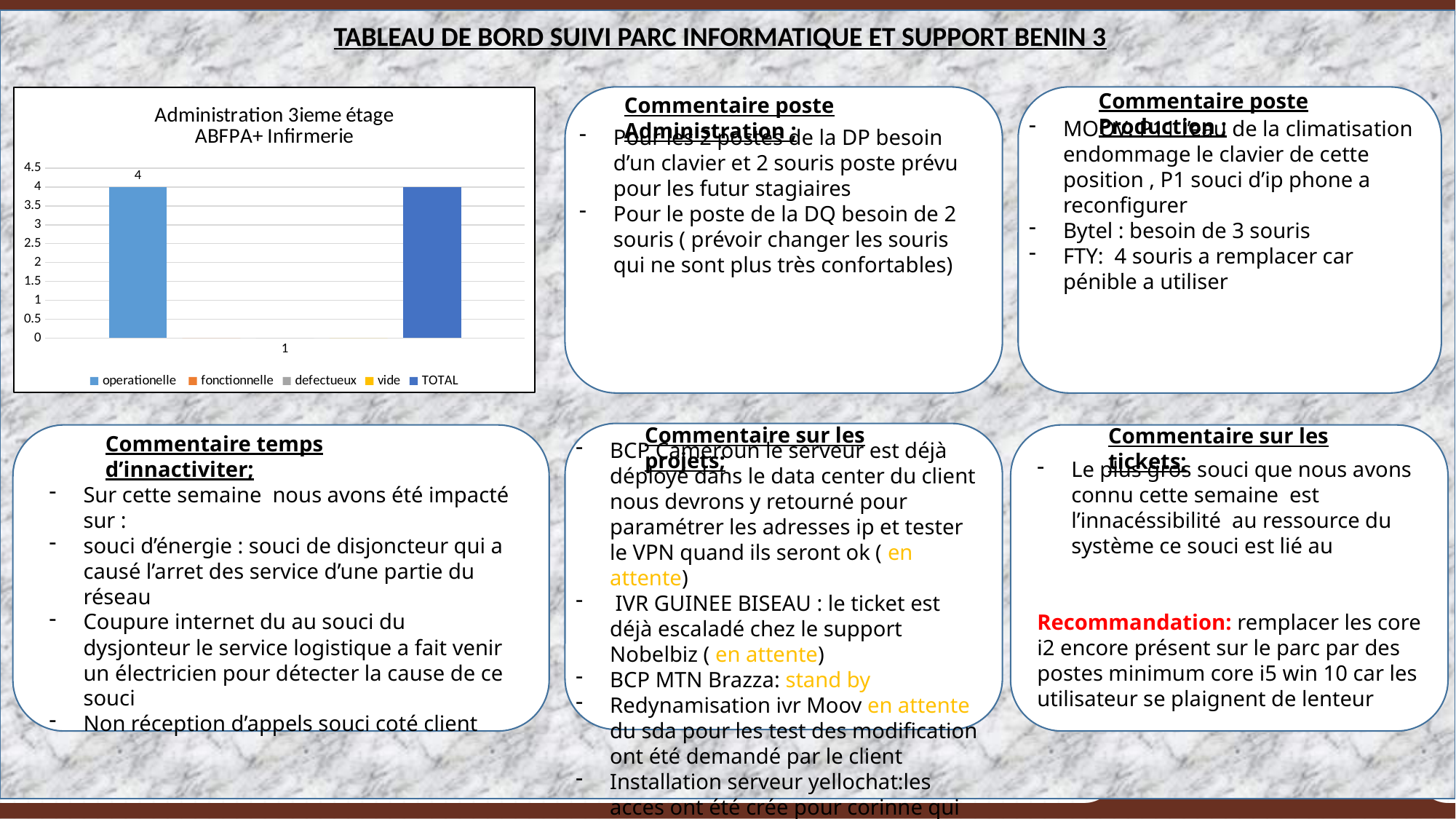
How many series does the chart legend list? 5 What is the highest value shown on the vertical axis of the chart? 4.5 Is the value of the TOTAL bar greater or less than 2? greater What is the value of the operationelle bar? 4 Which is larger, the operationelle bar or the fonctionnelle bar? operationelle How many categories are shown on the x axis of the chart? 1 What is the title of the chart? Administration 3ieme étage ABFPA+ Infirmerie Is the value of the operationelle bar greater or less than 3? greater What kind of chart is shown on the slide? bar chart